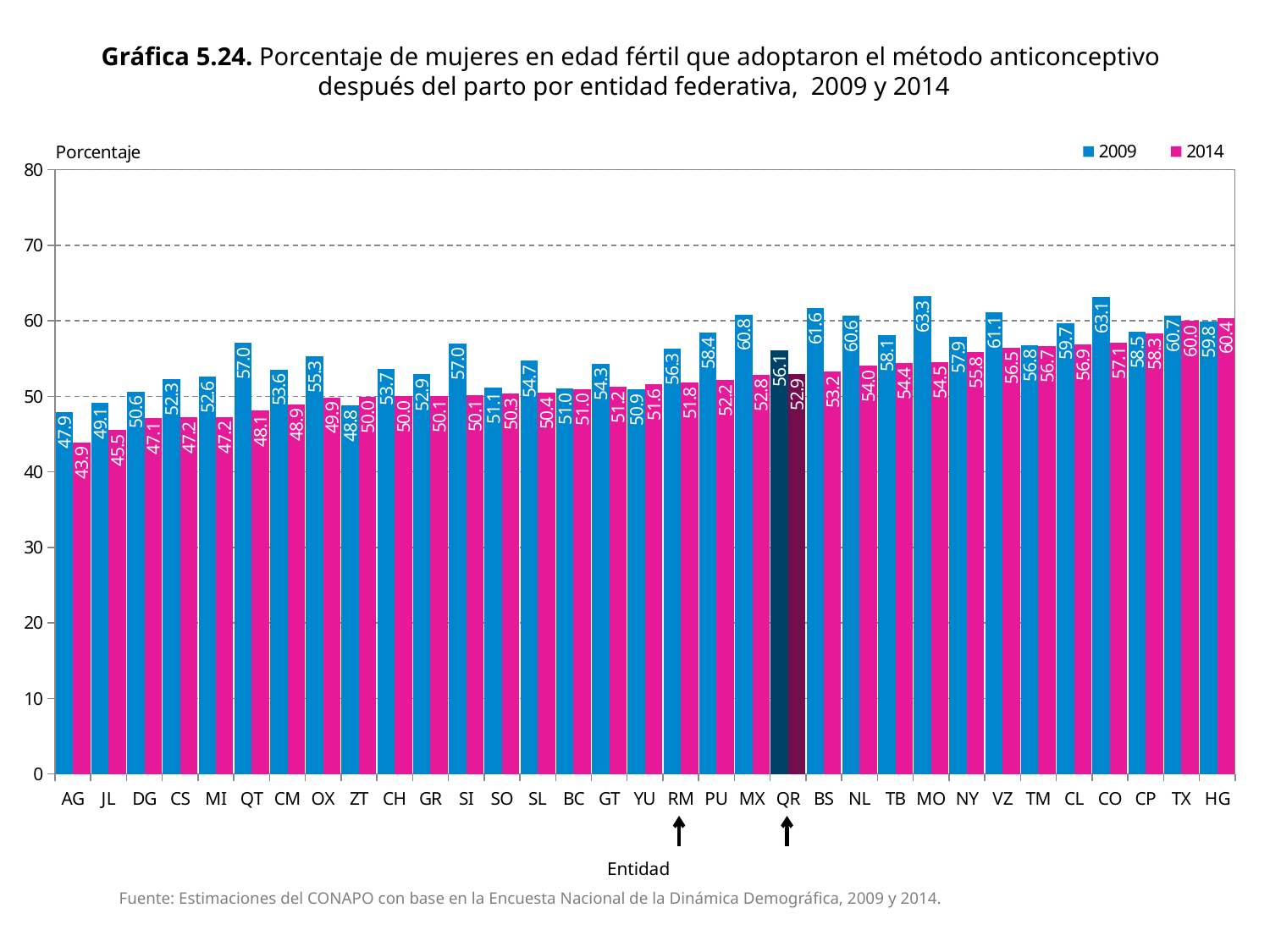
What kind of chart is shown on the slide? bar chart Which colour represents the 2014 series in the legend? pink (magenta) Which entity has the lowest 2014 value? AG Do the 2014 values generally rise or fall from left to right along the x axis? rise How many series does the legend list? 2 Is the 2009 value for MO greater or less than 60? greater What is the difference between the 2009 and 2014 values for AG? 4.0 What is the 2009 value for AG? 47.9 Which entity has the highest 2014 value? HG For QT, which year has the larger value, 2009 or 2014? 2009 What is the 2014 value for HG? 60.4 What is the 2009 value for QR? 56.1